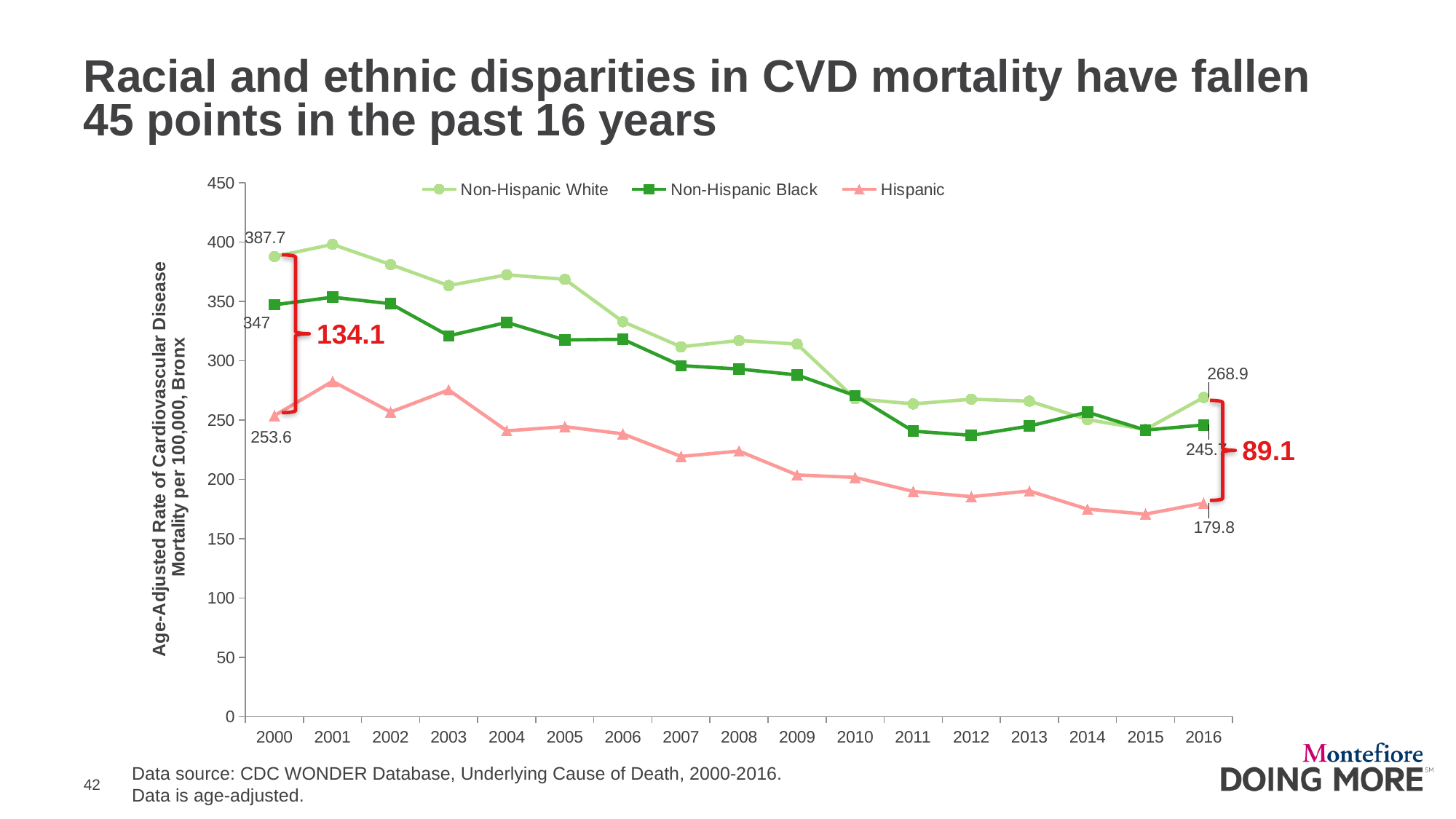
How many series does the legend list? 3 What is the Hispanic CVD mortality rate in 2000? 253.6 What is the Non-Hispanic White CVD mortality rate in 2000? 387.7 What kind of chart is shown on the slide? line chart What is the Hispanic CVD mortality rate in 2016? 179.8 What is the difference between the Non-Hispanic White and Hispanic rates in 2000? 134.1 What is the difference between the Non-Hispanic White and Hispanic rates in 2016? 89.1 What is the Non-Hispanic Black CVD mortality rate in 2000? 347 Which series has the highest value in 2000? Non-Hispanic White Is the Hispanic value for 2015 greater or less than 200? less What is the Non-Hispanic White CVD mortality rate in 2016? 268.9 Does the Non-Hispanic White series rise or fall from 2000 to 2016? fall